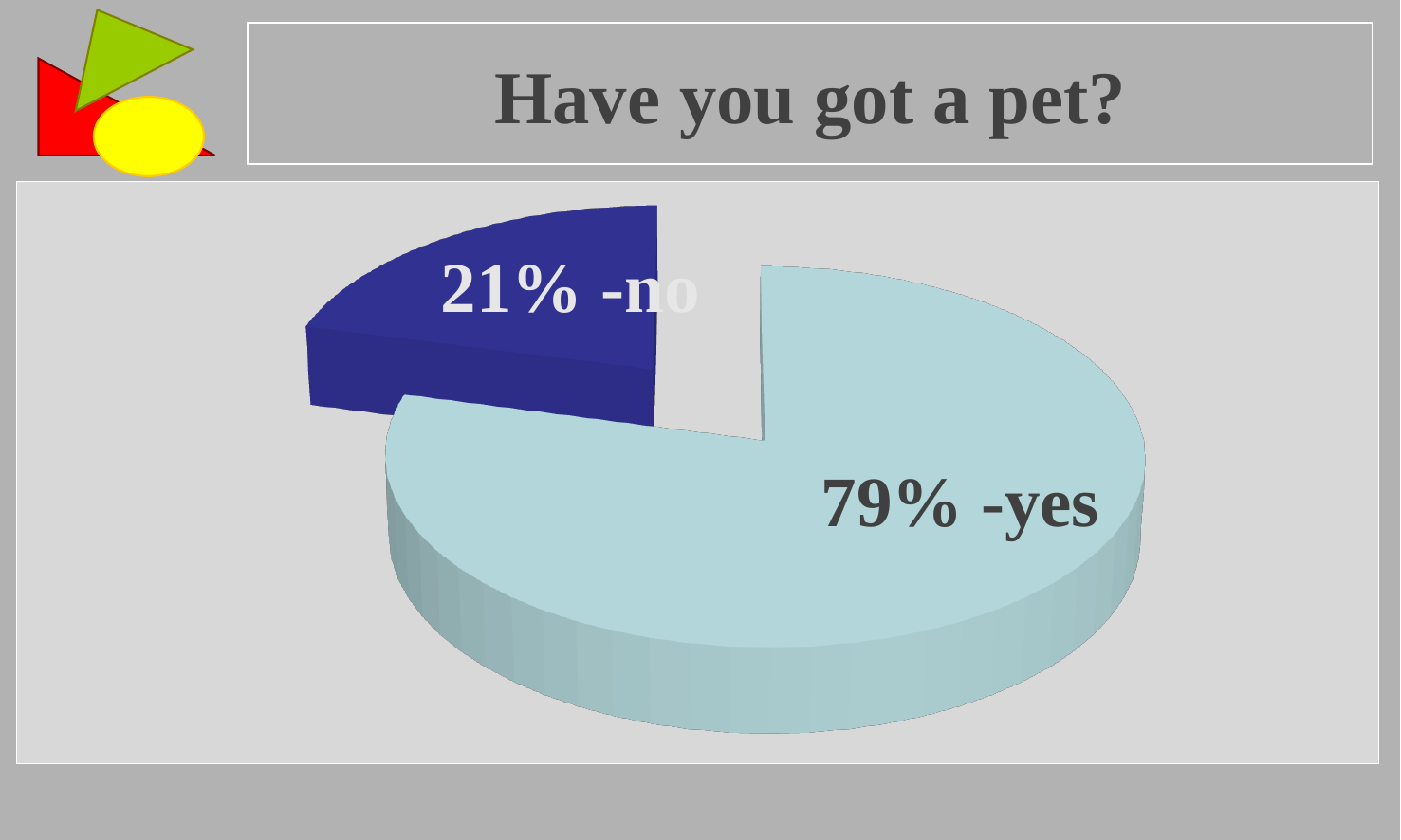
How many slices does the pie chart have? 2 What percentage of respondents answered "yes"? 79% What percentage of respondents answered "no"? 21% What is the title of the chart? Have you got a pet? What share of the pie does the "no" slice represent? 21% What kind of chart is shown on the slide? pie chart Which answer has the largest share of the pie? yes What is the difference in percentage points between the "yes" and "no" slices? 58 What colour is the "no" slice? dark blue Which is larger, the share for "yes" or the share for "no"? yes Which answer has the smallest share of the pie? no